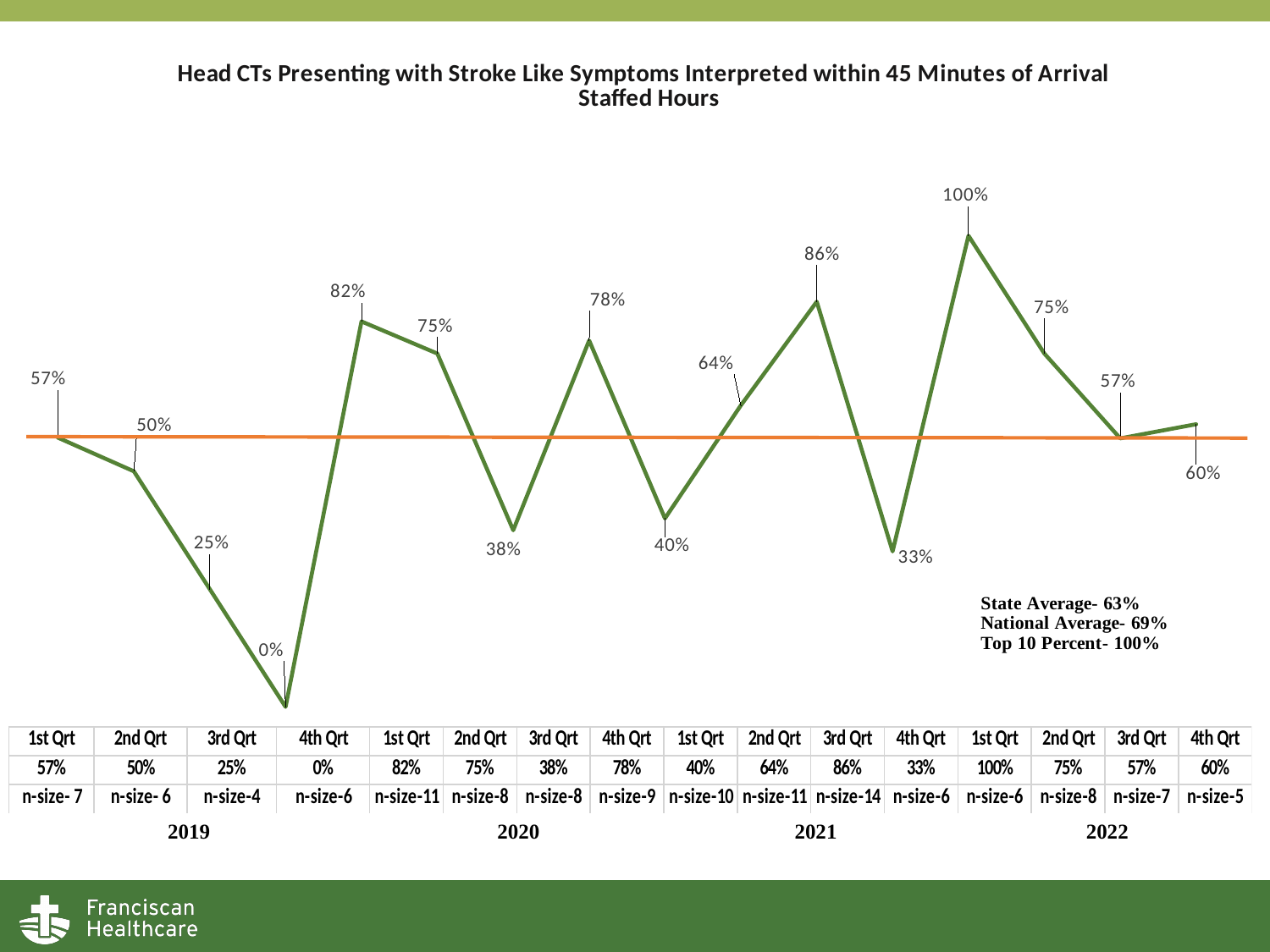
How many quarterly data points are plotted on the chart? 16 What type of chart is shown on the slide? line chart Which is larger, the value for the 4th Qrt of 2020 or the 4th Qrt of 2021? 4th Qrt 2020 What is the n-size for the 3rd Qrt of 2021? n-size-14 What is the value for the 1st Qrt of 2022? 100% What is the difference between the 1st Qrt 2020 value and the 2nd Qrt 2020 value? 7% What State Average is listed on the slide? 63% Which quarter has the highest value? 1st Qrt 2022 Do the values rise or fall from the 1st Qrt of 2019 to the 4th Qrt of 2019? fall What is the value for the 3rd Qrt of 2021? 86% What is the value for the 4th Qrt of 2019? 0% Which quarter has the lowest value? 4th Qrt 2019